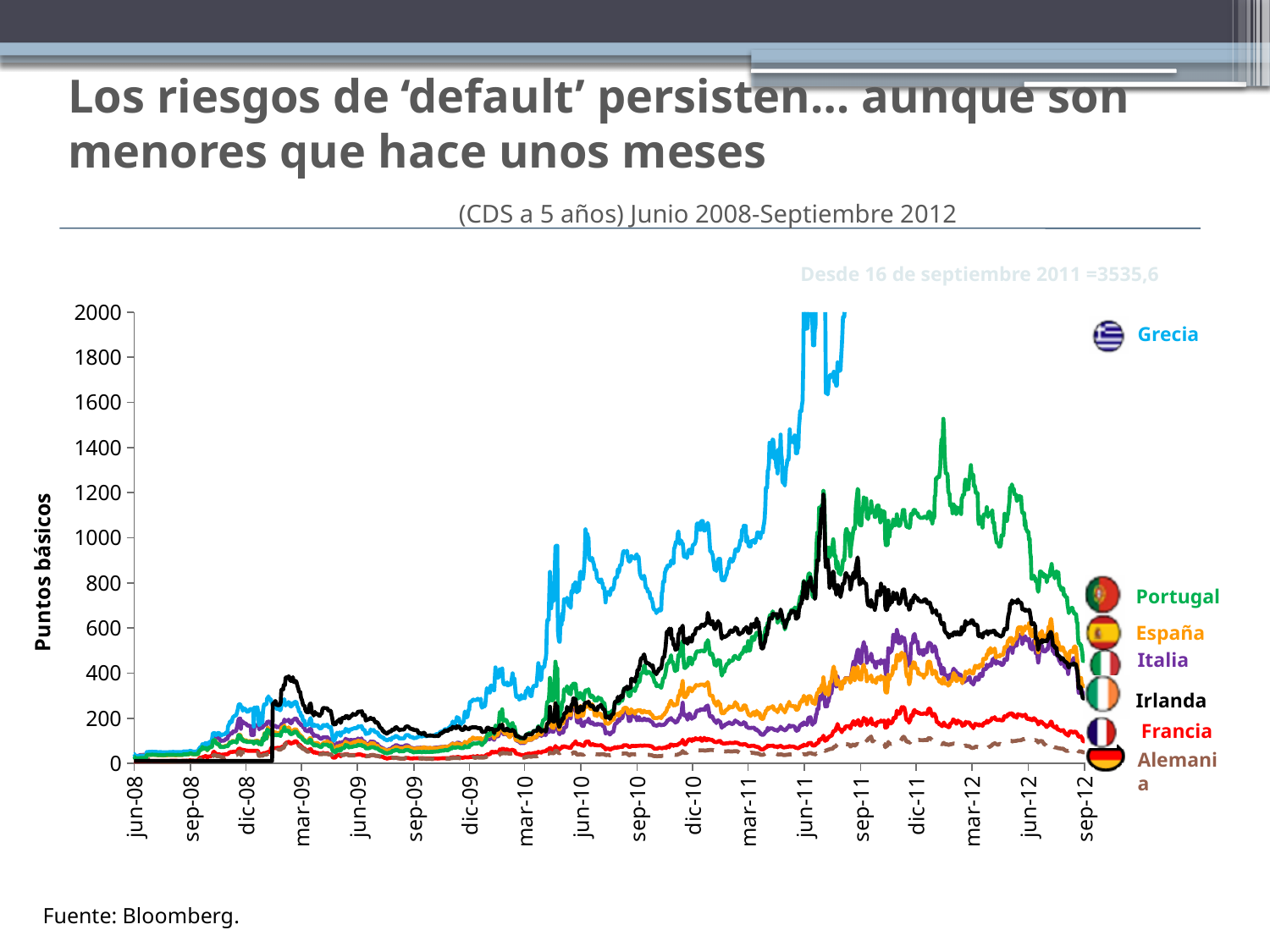
Does the line for Portugal rise or fall between June 2012 and September 2012? fall What is the highest tick value shown on the vertical axis? 2000 Is the peak value for Irlanda in mid-2011 greater or less than 1000? greater Which is larger in June 2011, the value for Grecia or the value for Alemania? Grecia What value does the annotation give for Grecia since 16 September 2011? 3535,6 What kind of chart is shown on the slide? line chart Is the value for Francia in June 2012 greater or less than 400? less Is the peak value for Portugal in early 2012 greater or less than 1400? greater How many countries (series) are labelled on the chart? 7 What is the label of the vertical axis? Puntos básicos Which country's line reaches the highest values on the chart? Grecia